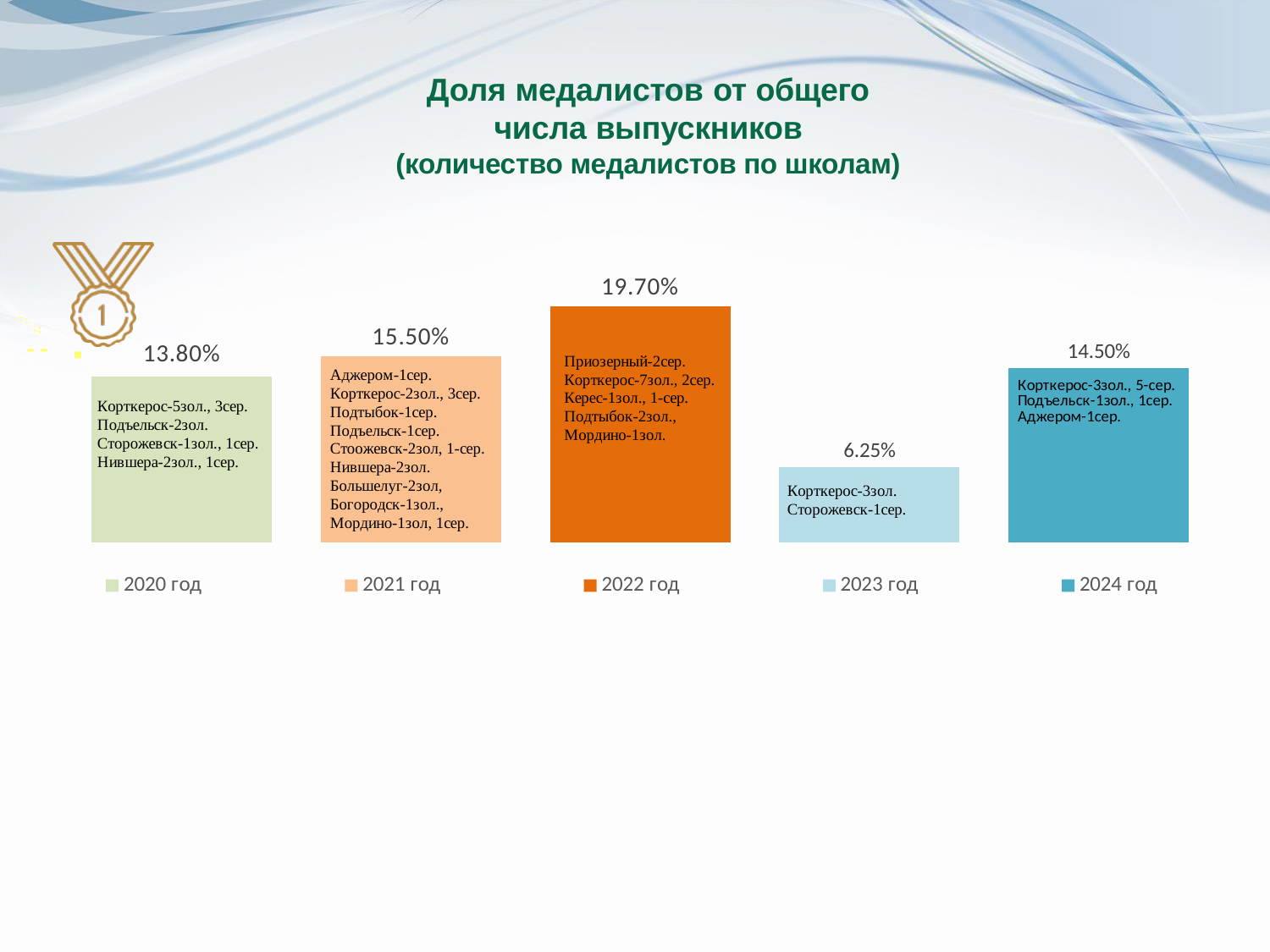
What is the difference between the values for 2022 год and 2023 год? 13.45% Which year has the lowest share of medalists? 2023 год How many entries does the legend list? 5 What is the value shown for 2022 год? 19.70% How many bars are plotted in the chart? 5 What is the value shown for 2024 год? 14.50% What is the value shown for 2023 год? 6.25% Which year has the highest share of medalists? 2022 год What is the value shown for 2020 год? 13.80% What is the difference between the values for 2021 год and 2020 год? 1.70% Which is larger, the value for 2021 год or the value for 2024 год? 2021 год What kind of chart is shown on the slide? Bar chart